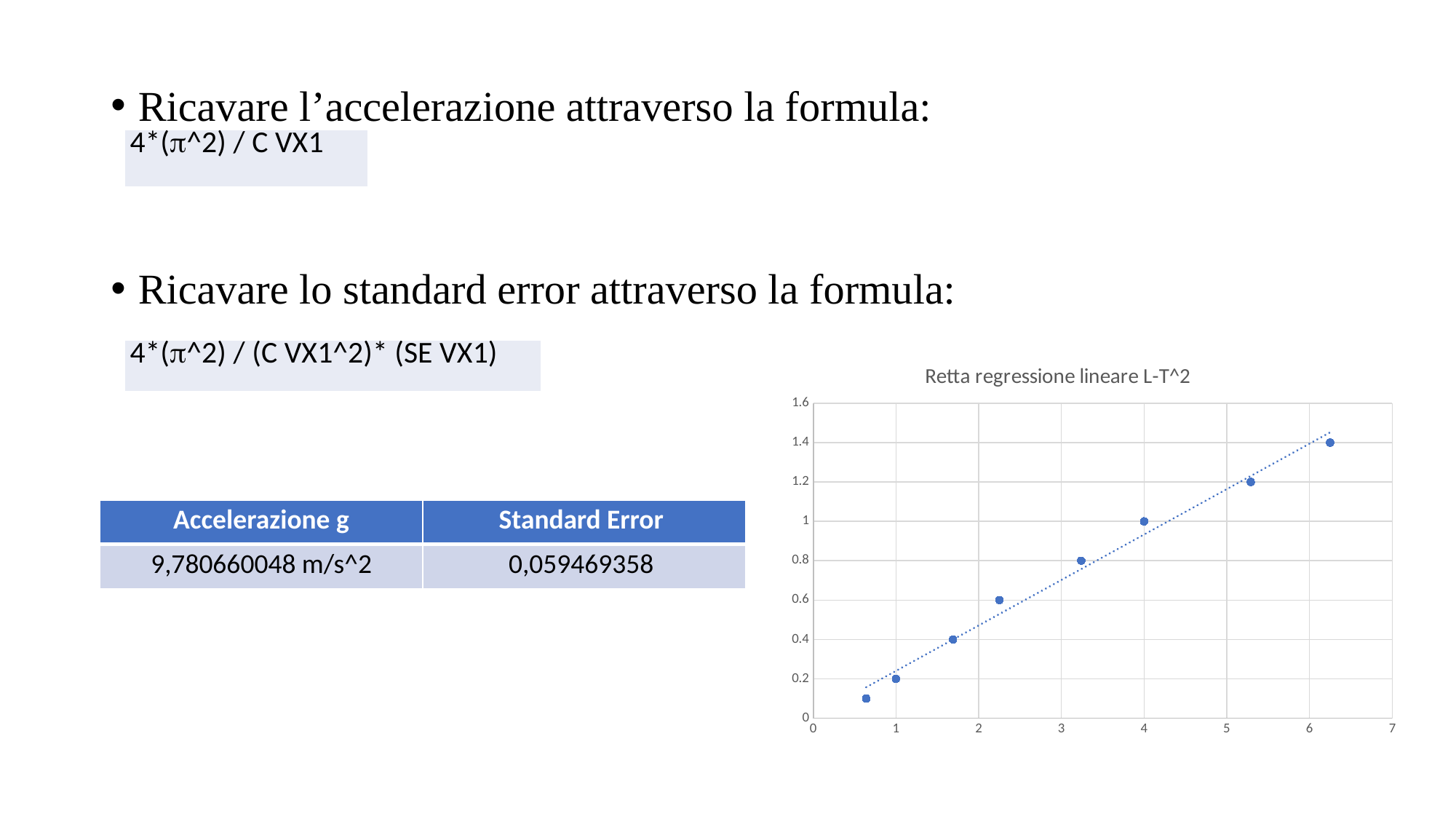
What kind of chart is shown on the slide? scatter chart How many data points are plotted in the chart? 8 Is the y value of the lowest plotted point greater or less than 0.2? less Which has the larger y value: the rightmost point or the leftmost point? the rightmost point Do the plotted values rise or fall as the x value increases? rise What is the maximum value shown on the y axis? 1.6 What is the title of the chart? Retta regressione lineare L-T^2 Is the x value of the leftmost plotted point greater or less than 1? less Is the y value of the highest plotted point greater or less than 1.2? greater